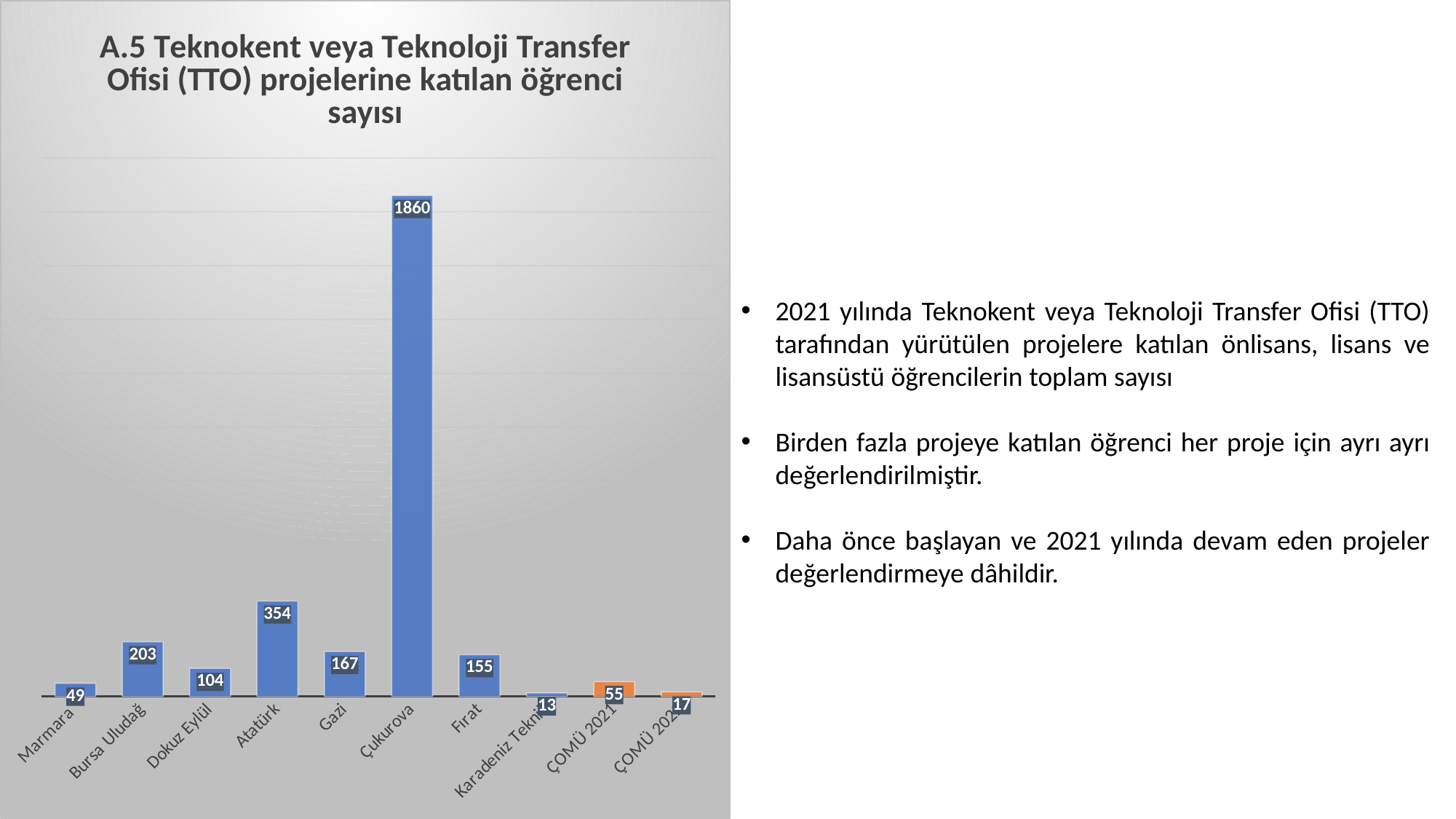
Which category has the highest value? Çukurova How many categories are shown on the x axis? 10 Which is larger, the value for Dokuz Eylül or the value for Marmara? Dokuz Eylül What kind of chart is this? Bar chart What is the value for ÇOMÜ 2021? 55 What is the value for Bursa Uludağ? 203 Which category has the lowest value? Karadeniz Teknik What is the difference between the values for Gazi and Fırat? 12 What is the value for Karadeniz Teknik? 13 What is the value for Çukurova? 1860 What is the difference between the values for Atatürk and Bursa Uludağ? 151 What is the value for Atatürk? 354